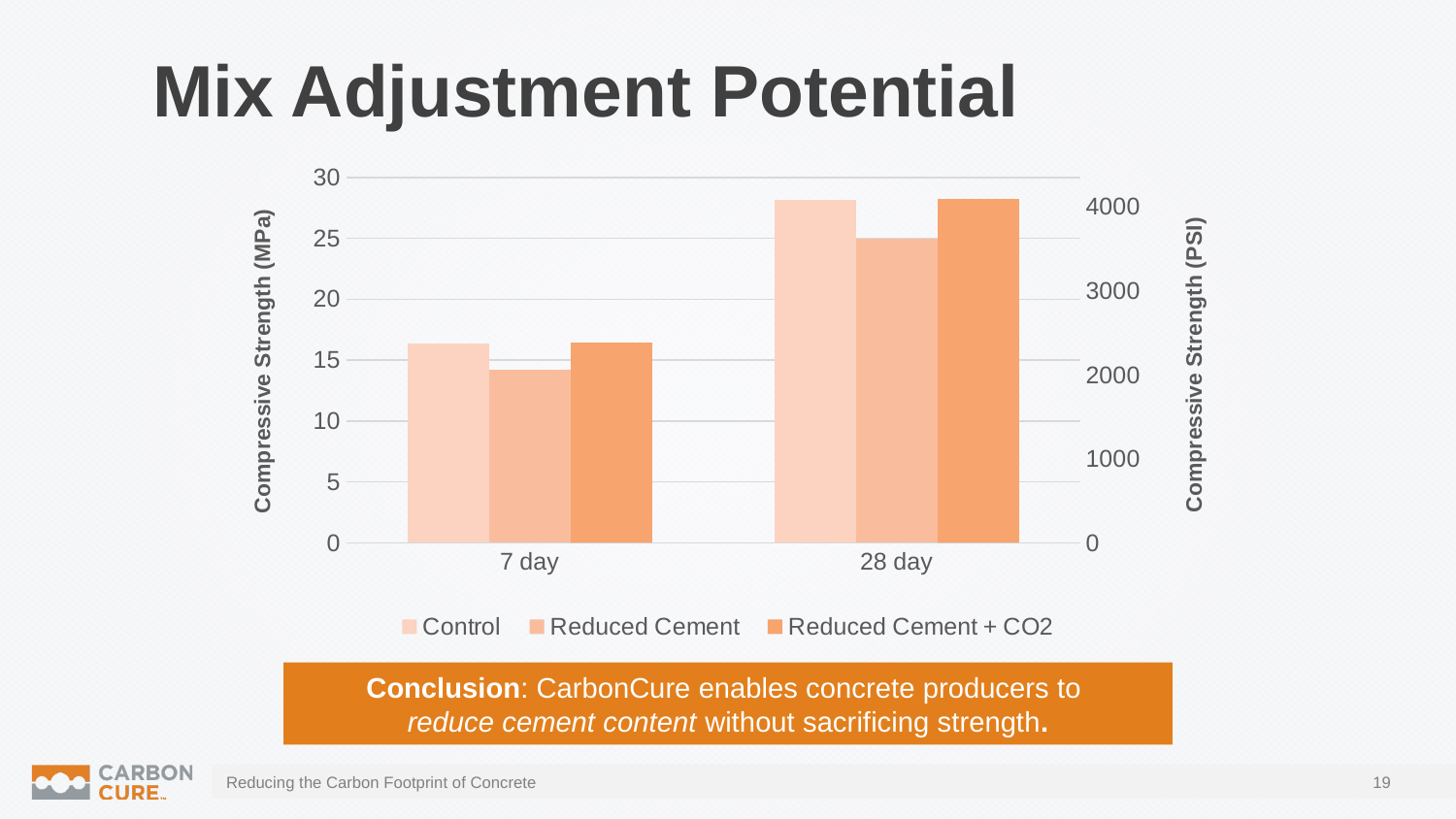
What kind of chart is shown on the slide? bar chart What is the label of the left vertical axis of the chart? Compressive Strength (MPa) Is the 28 day value for Reduced Cement + CO2 greater or less than 3000 PSI? greater Is the 28 day value for Control greater or less than 25 MPa? greater Is the 7 day value for Reduced Cement greater or less than 15 MPa? less Which is larger: the Control value at 7 day or the Control value at 28 day? 28 day Which series has the lowest value in the 7 day group? Reduced Cement How many series does the chart's legend list? 3 How many categories are shown on the x axis of the chart? 2 In the 7 day group, which is larger: Control or Reduced Cement? Control Do the compressive strength values rise or fall from 7 day to 28 day? rise